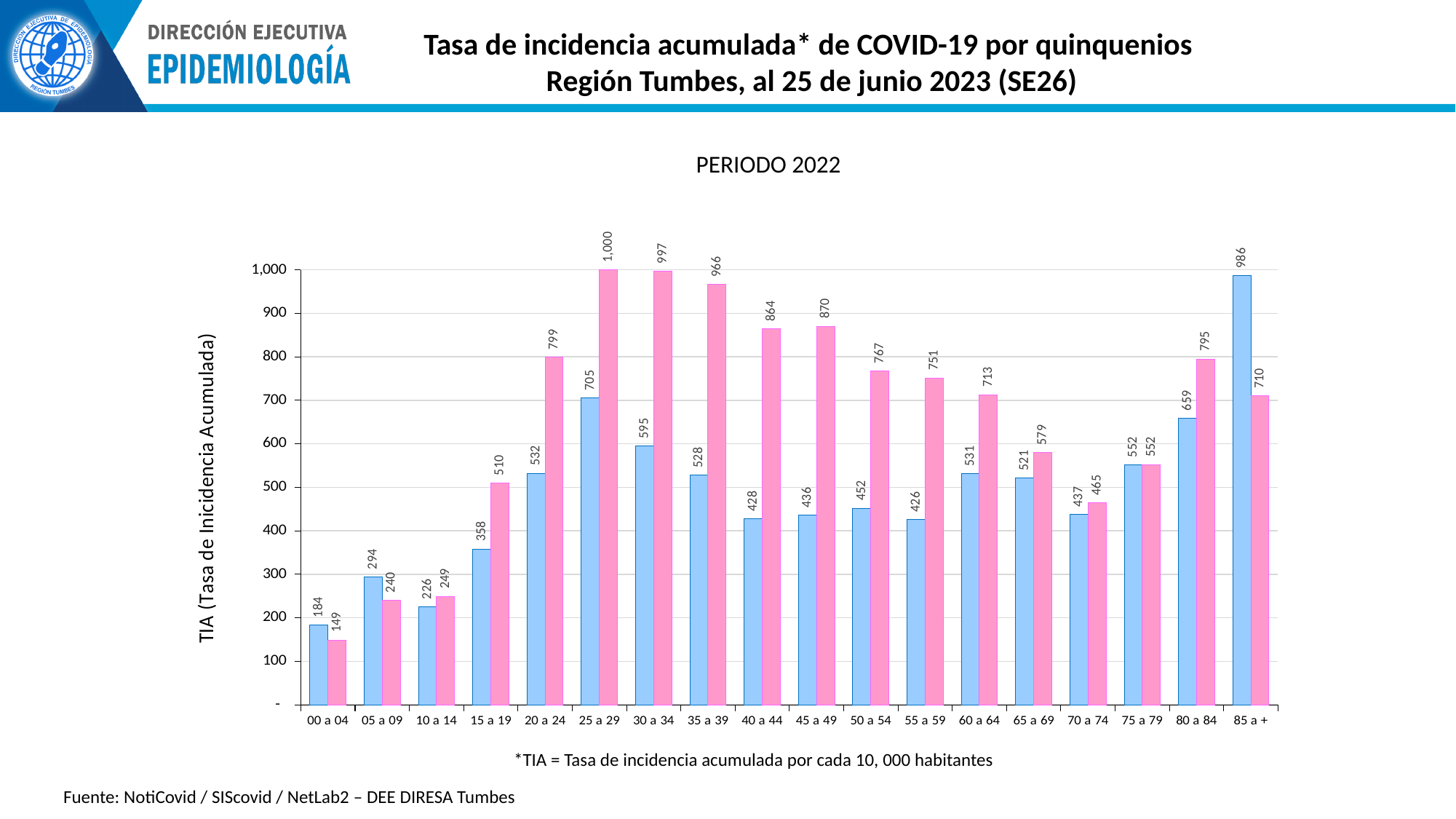
Which age group has the highest blue bar? 85 a + What is the difference between the pink and blue bars for the 20 a 24 age group? 267 Which age group has the lowest pink bar? 00 a 04 Which is larger for the 85 a + age group, the blue bar or the pink bar? the blue bar What is the chart's title? PERIODO 2022 How many age-group categories are shown on the x axis? 18 What is the difference between the blue bars for the 85 a + and 80 a 84 age groups? 327 Which age group has the highest pink bar? 25 a 29 What is the value of the pink bar for the 75 a 79 age group? 552 What is the value of the pink bar for the 40 a 44 age group? 864 What is the value of the blue bar for the 25 a 29 age group? 705 What type of chart is shown on the slide? bar chart